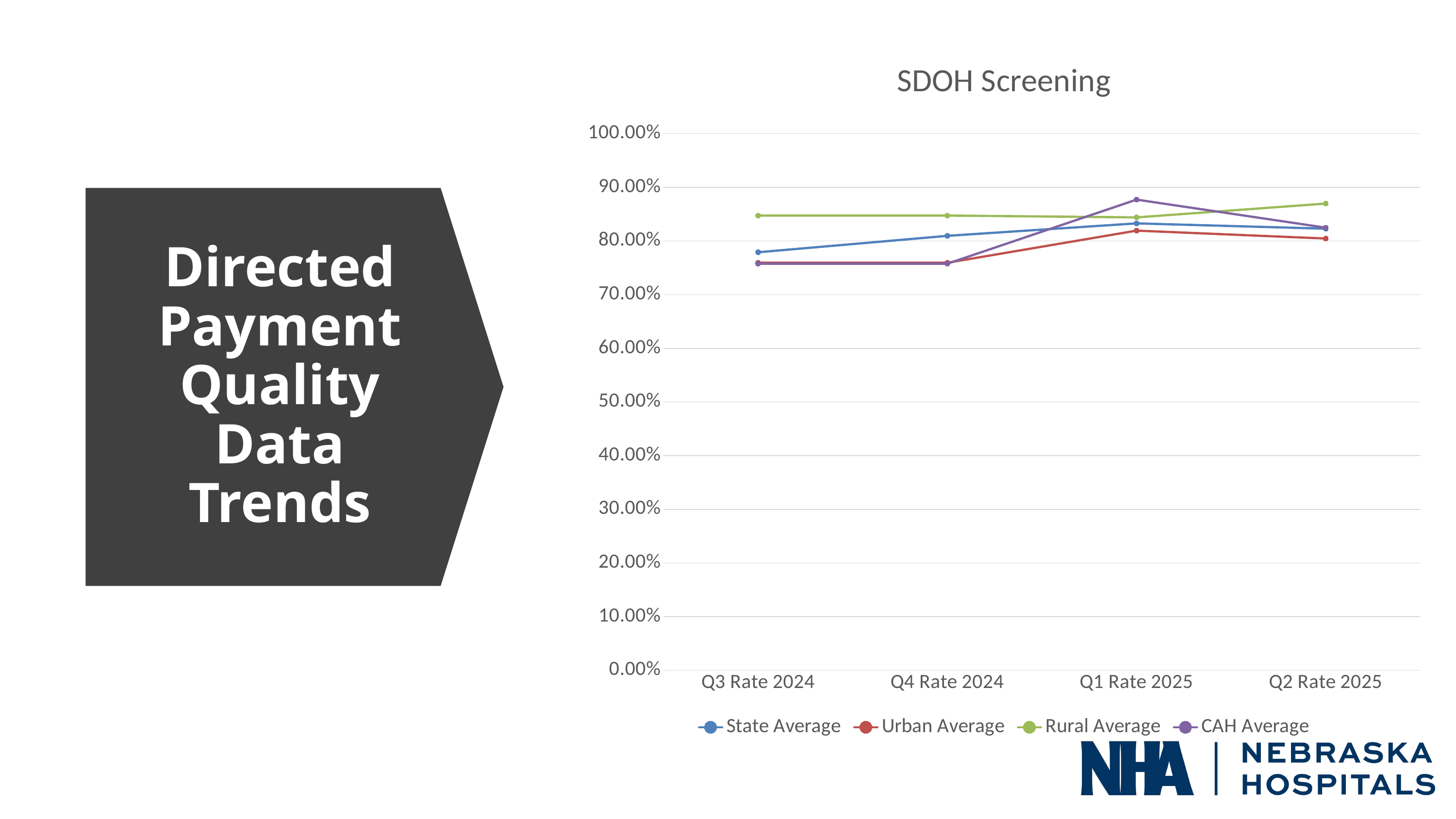
Which series is highest at Q2 Rate 2025? Rural Average Is the value for Rural Average at Q3 Rate 2024 greater or less than 80.00%? greater What is the title of the chart? SDOH Screening Which series is highest at Q1 Rate 2025? CAH Average Is the value for Urban Average at Q3 Rate 2024 greater or less than 80.00%? less How many quarters are shown along the x axis? 4 What kind of chart is shown on the slide? Line chart Which is larger at Q1 Rate 2025, CAH Average or Rural Average? CAH Average Which series is highest at Q3 Rate 2024? Rural Average Does the CAH Average rise or fall from Q1 Rate 2025 to Q2 Rate 2025? Fall How many series does the legend list? 4 Is the value for CAH Average at Q1 Rate 2025 greater or less than 80.00%? greater